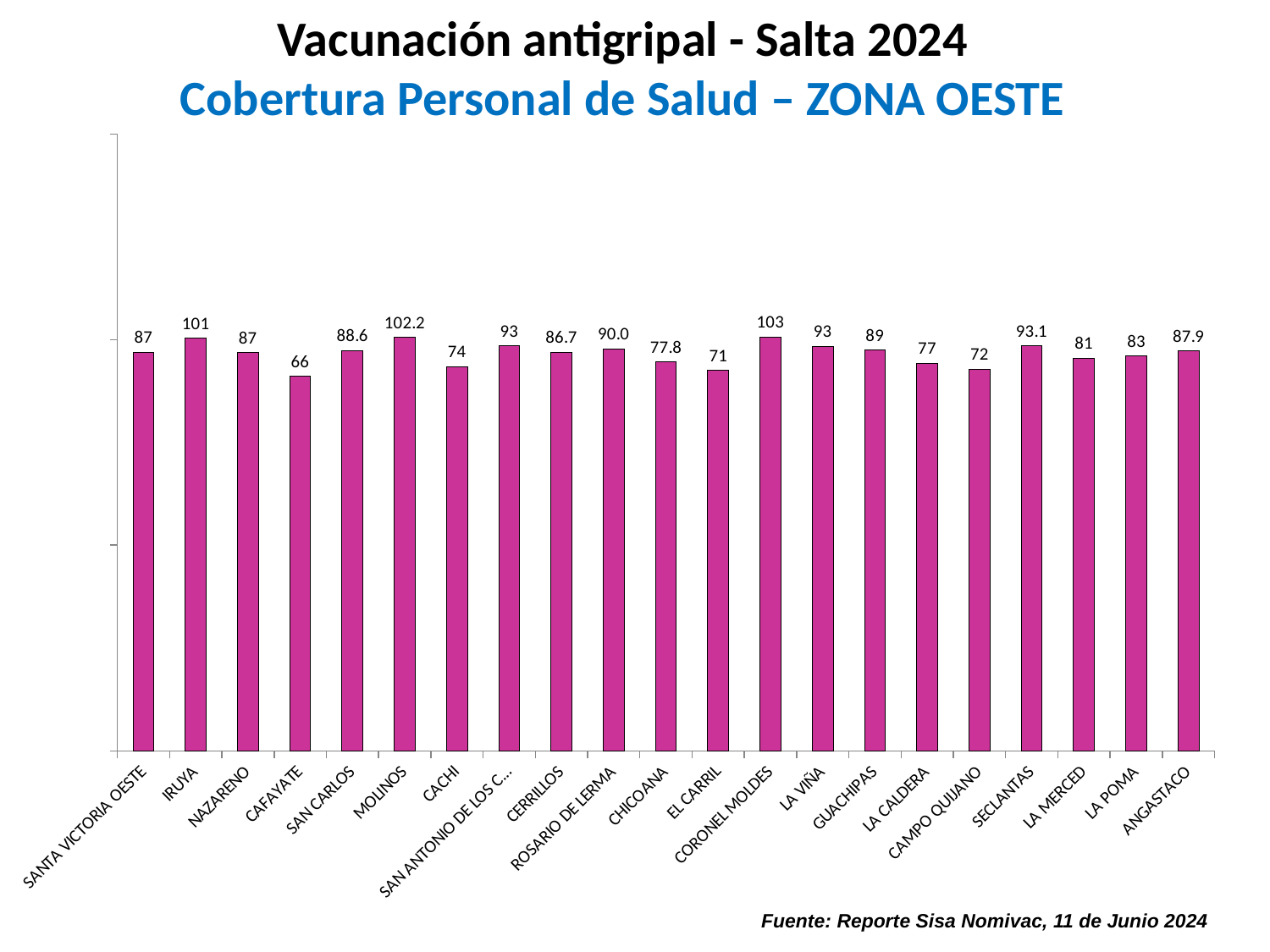
What is the value for MOLINOS? 102.2 What is the value for SECLANTAS? 93.1 How many categories are shown on the x axis? 21 What kind of chart is shown on the slide? Bar chart Which category has the highest value? CORONEL MOLDES What is the value for ROSARIO DE LERMA? 90.0 What is the difference between the values for IRUYA and CAFAYATE? 35 What is the difference between the values for MOLINOS and CACHI? 28.2 Which is larger, the value for CHICOANA or the value for CACHI? CHICOANA Which category has the lowest value? CAFAYATE What colour are the bars in the chart? Magenta (pink) What is the value for CAFAYATE? 66